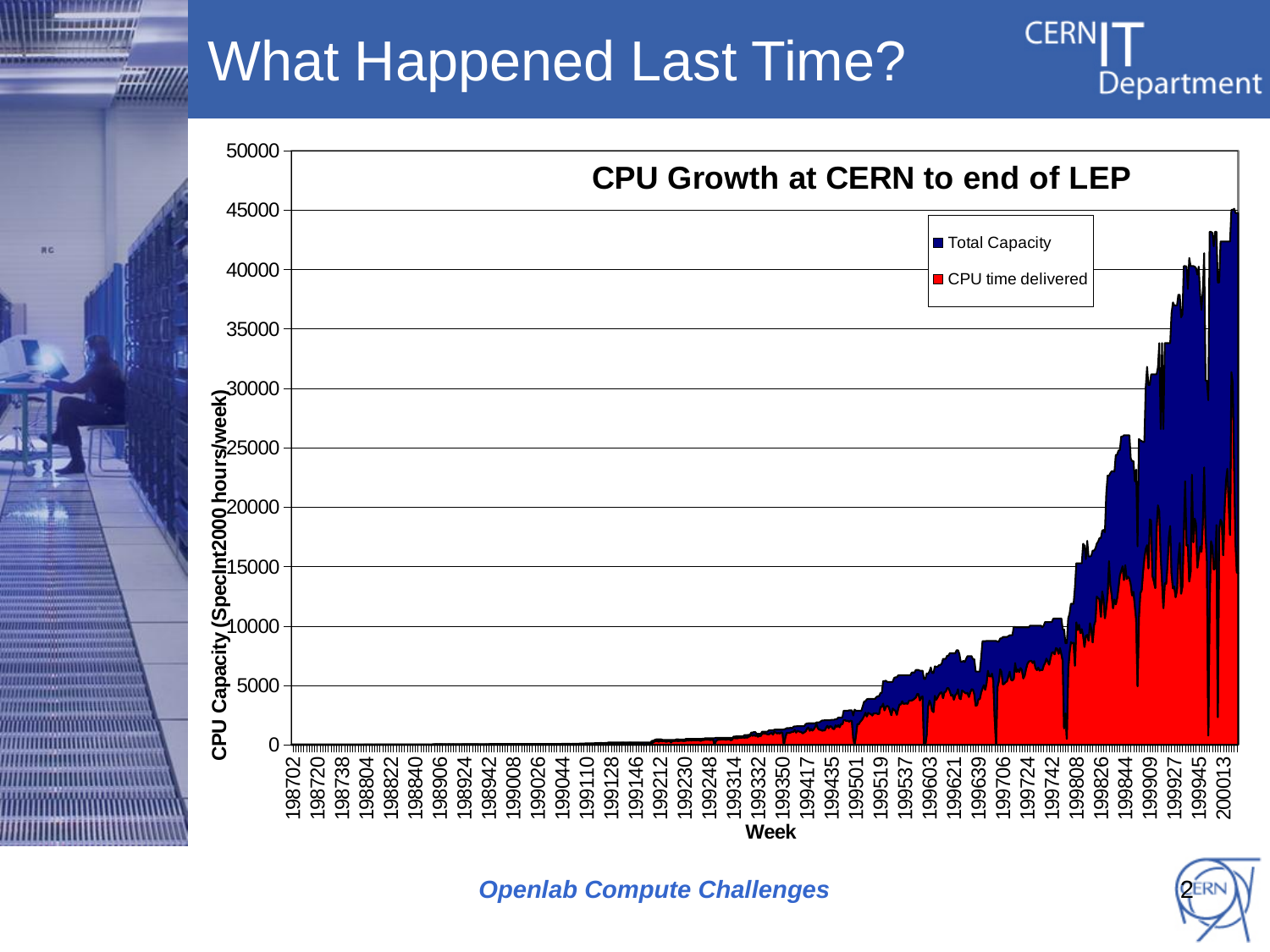
What is the title of the chart? CPU Growth at CERN to end of LEP Does Total Capacity rise or fall over the weeks shown on the x axis? Rise Which series is shown in red in the chart? CPU time delivered Is the CPU time delivered value at week 199417 greater or less than 5000? less How many series does the legend of the CPU Growth chart list? 2 What is the highest value shown on the y axis of the chart? 50000 What kind of chart is shown on the slide? Area chart What is the first week label shown on the x axis? 198702 What is the label of the x axis of the chart? Week